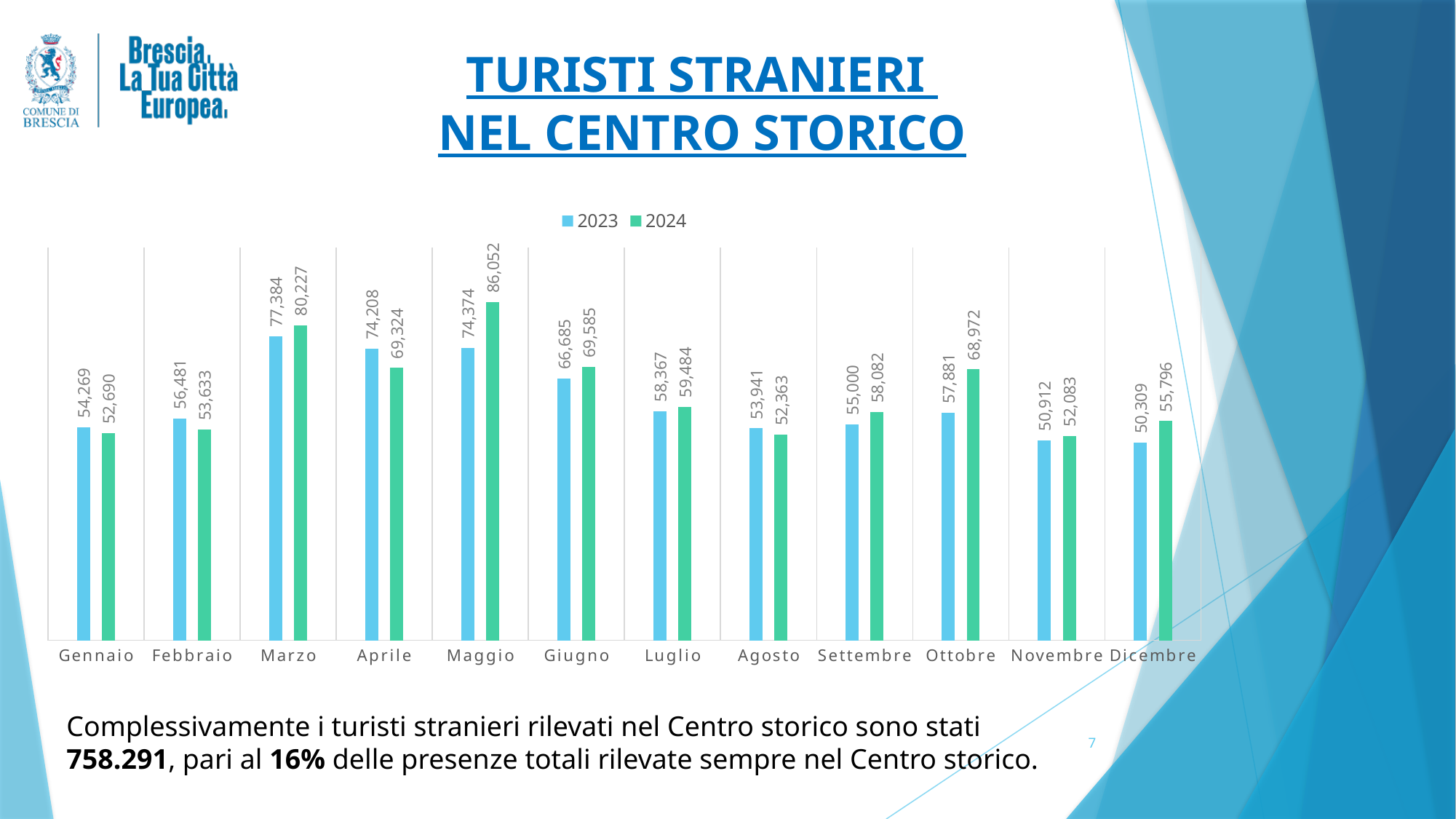
How many months are shown on the x axis? 12 How many series does the legend list? 2 In Agosto, which series has the larger value, 2023 or 2024? 2023 Which month has the lowest value for the 2023 series? Dicembre What kind of chart is shown on the slide? Bar chart Which month has the highest value for the 2024 series? Maggio Which month has the highest value for the 2023 series? Marzo What is the value for 2023 in Settembre? 55,000 What is the difference between the 2024 and 2023 values in Ottobre? 11,091 What is the value for 2024 in Maggio? 86,052 What is the difference between the 2023 and 2024 values in Aprile? 4,884 What is the value for 2023 in Ottobre? 57,881